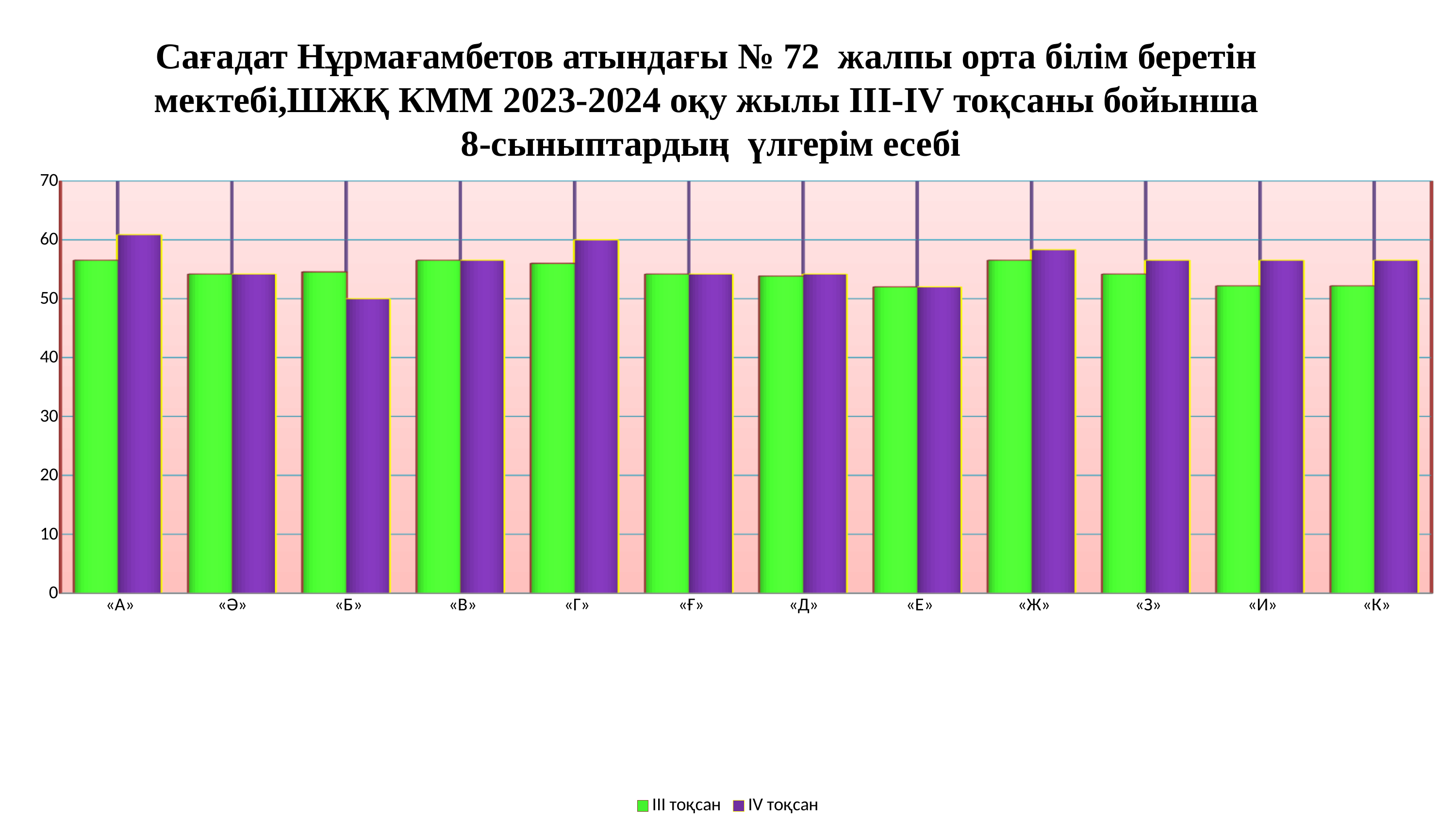
Which category has the lowest value for IV тоқсан? «Б» Is the III тоқсан value for «Е» greater or less than 50? greater Is the IV тоқсан value for «А» greater or less than 60? greater What are the two legend entries of the chart? III тоқсан and IV тоқсан What kind of chart is shown on the slide? bar chart How many series does the legend list? 2 For «И», which is larger: the III тоқсан value or the IV тоқсан value? IV тоқсан How many class categories are shown along the x axis? 12 Which series is shown in green? III тоқсан For «Б», which is larger: the III тоқсан value or the IV тоқсан value? III тоқсан Is the III тоқсан value for «В» greater or less than 60? less